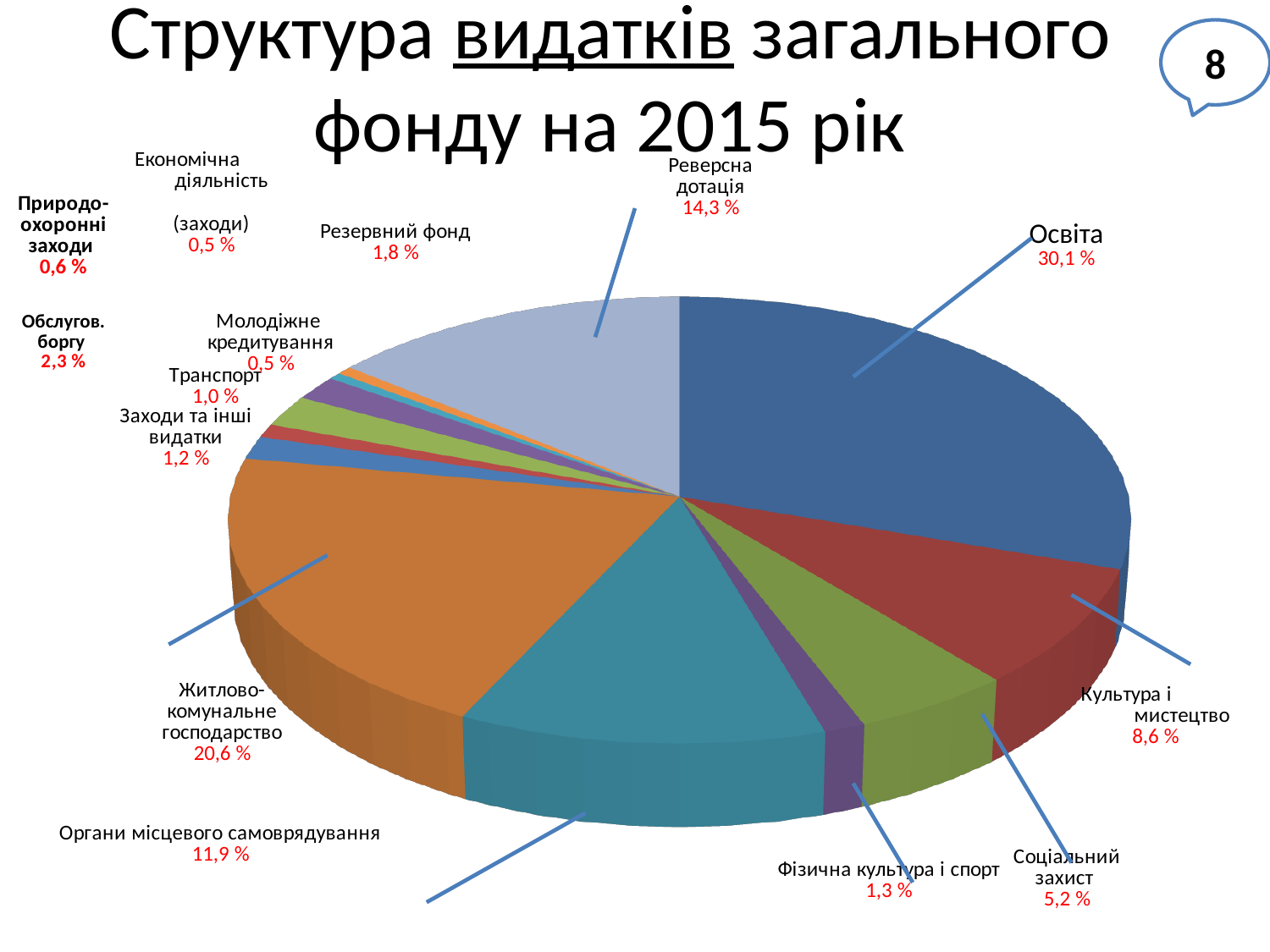
How many categories are labelled on the pie chart? 14 Which category has the largest share of the pie? Освіта What is the value shown for Житлово-комунальне господарство? 20,6 % What is the value shown for Обслугов. боргу? 2,3 % What is the difference between the shares of Освіта and Житлово-комунальне господарство? 9,5 % What is the value shown for Реверсна дотація? 14,3 % What is the title of the slide? Структура видатків загального фонду на 2015 рік What kind of chart is shown on the slide? pie chart What is the value shown for Соціальний захист? 5,2 % What share of the pie does Освіта have? 30,1 % Which is larger, Культура і мистецтво or Соціальний захист? Культура і мистецтво What is the value shown for Органи місцевого самоврядування? 11,9 %